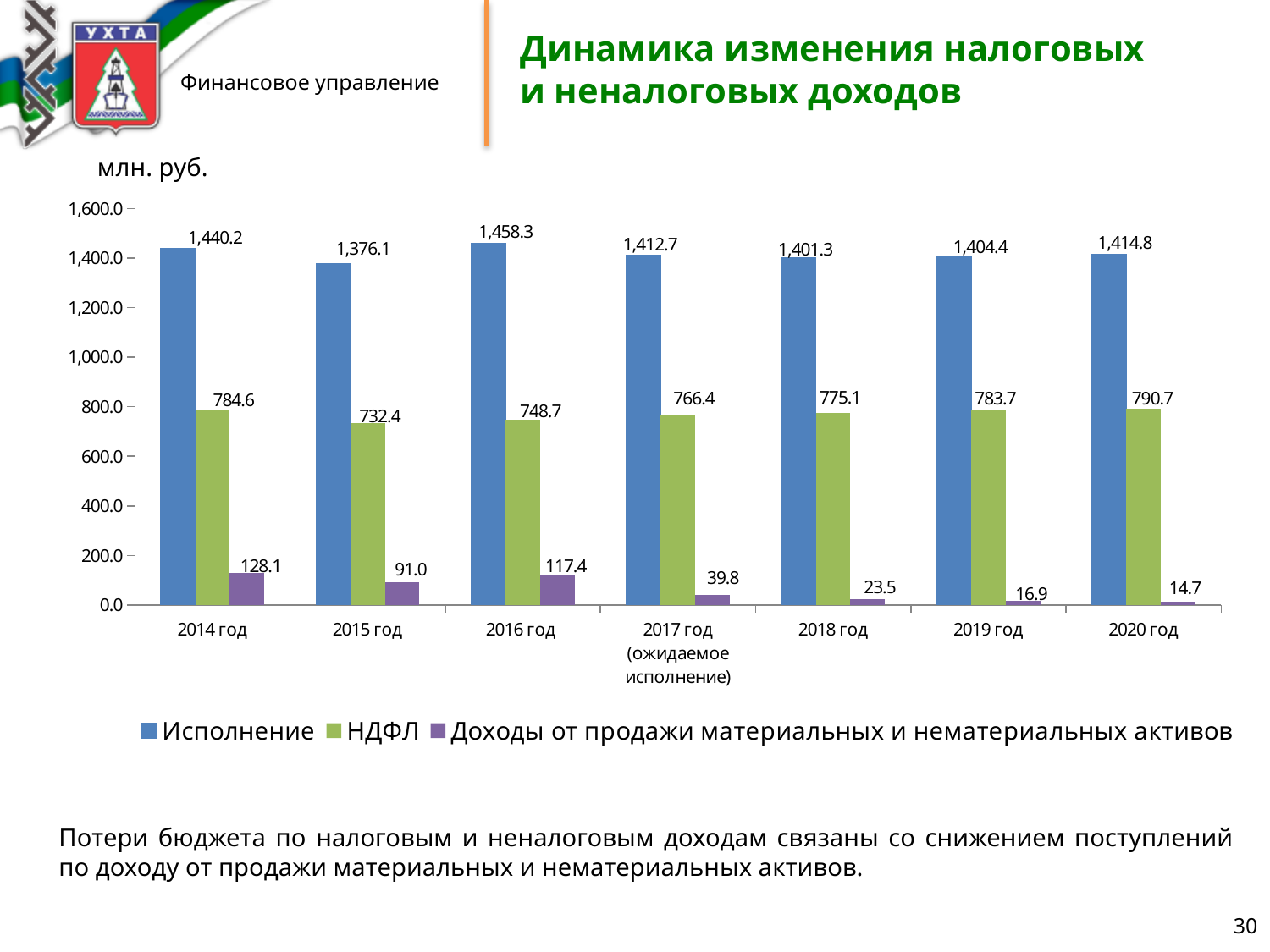
What kind of chart is shown on the slide? bar chart What is the difference between Исполнение in 2016 год and 2015 год? 82.2 Which is larger: НДФЛ in 2019 год or НДФЛ in 2018 год? 2019 год Does the series Доходы от продажи материальных и нематериальных активов rise or fall from 2016 год to 2020 год? fall What is the value of НДФЛ for 2017 год (ожидаемое исполнение)? 766.4 How many years are shown on the x axis? 7 In which year is Исполнение highest? 2016 год In which year is НДФЛ lowest? 2015 год What is the value of Исполнение for 2014 год? 1,440.2 How many series does the legend list? 3 What is the value of Доходы от продажи материальных и нематериальных активов for 2020 год? 14.7 Is the value of Доходы от продажи материальных и нематериальных активов for 2014 год greater or less than 200.0? less